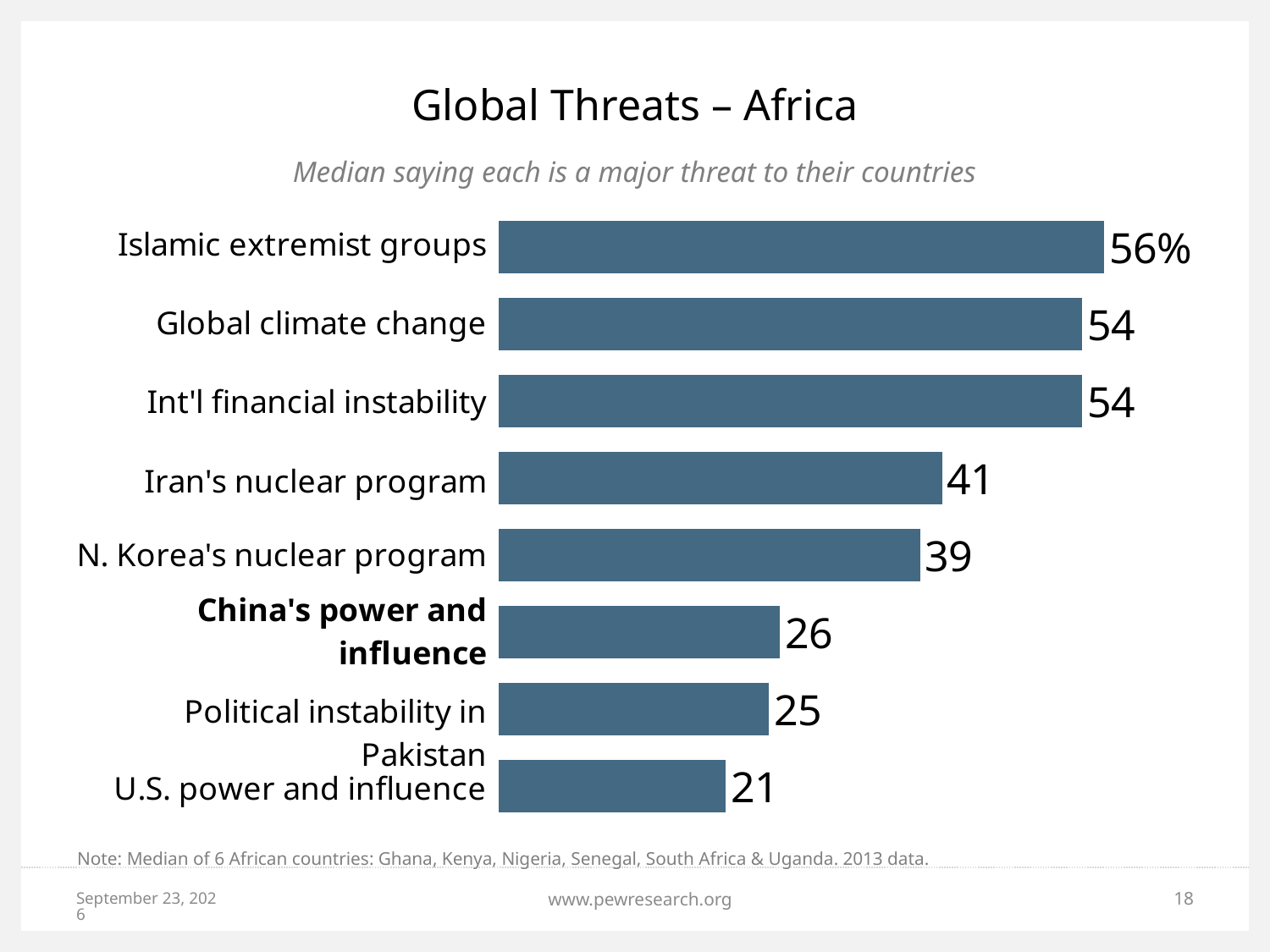
What is the difference between the values for Iran's nuclear program and N. Korea's nuclear program? 2 What is the difference between the values for Islamic extremist groups and U.S. power and influence? 35 What is the value for China's power and influence? 26 What is the value for Islamic extremist groups? 56% Which category has the lowest value? U.S. power and influence What is the value for Iran's nuclear program? 41 What is the title of the chart? Global Threats – Africa How many categories are shown in the chart? 8 What kind of chart is shown on the slide? Bar chart What is the value for U.S. power and influence? 21 Which category has the highest value? Islamic extremist groups Which is larger, the value for Global climate change or the value for Iran's nuclear program? Global climate change